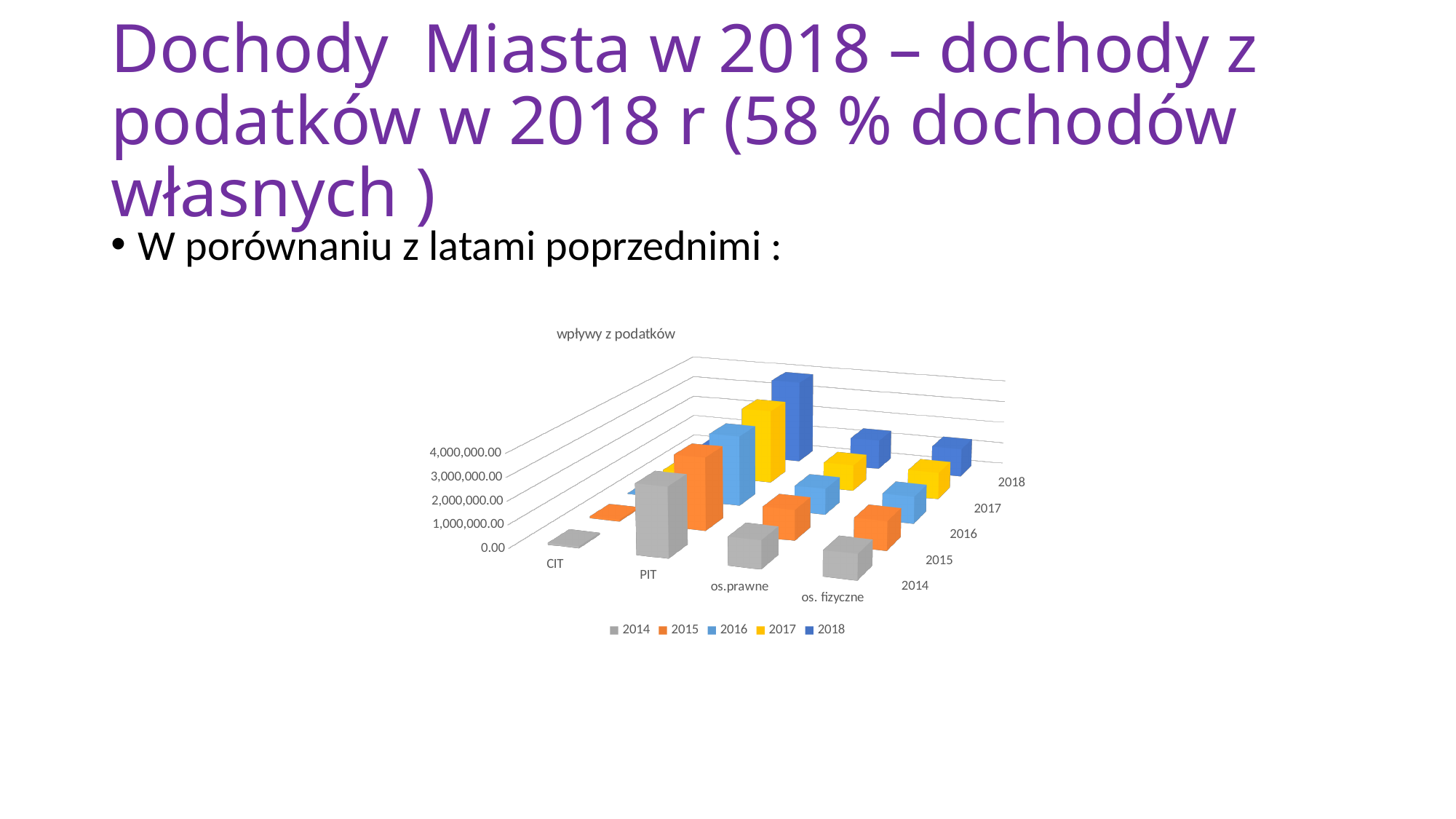
Which tax category has the highest values in the chart? PIT Which is larger in 2014, the value for PIT or the value for os. fizyczne? PIT Which tax category has the lowest values in the chart? CIT Is the value for CIT in 2014 greater or less than 1,000,000.00? less Which year is shown in dark blue in the chart legend? 2018 Do the PIT values rise or fall from 2014 to 2018? rise What kind of chart is shown on the slide? bar chart Which is larger in 2018, the value for PIT or the value for CIT? PIT How many tax categories are shown along the category axis of the chart? 4 What is the title of the chart? wpływy z podatków How many series does the chart legend list? 5